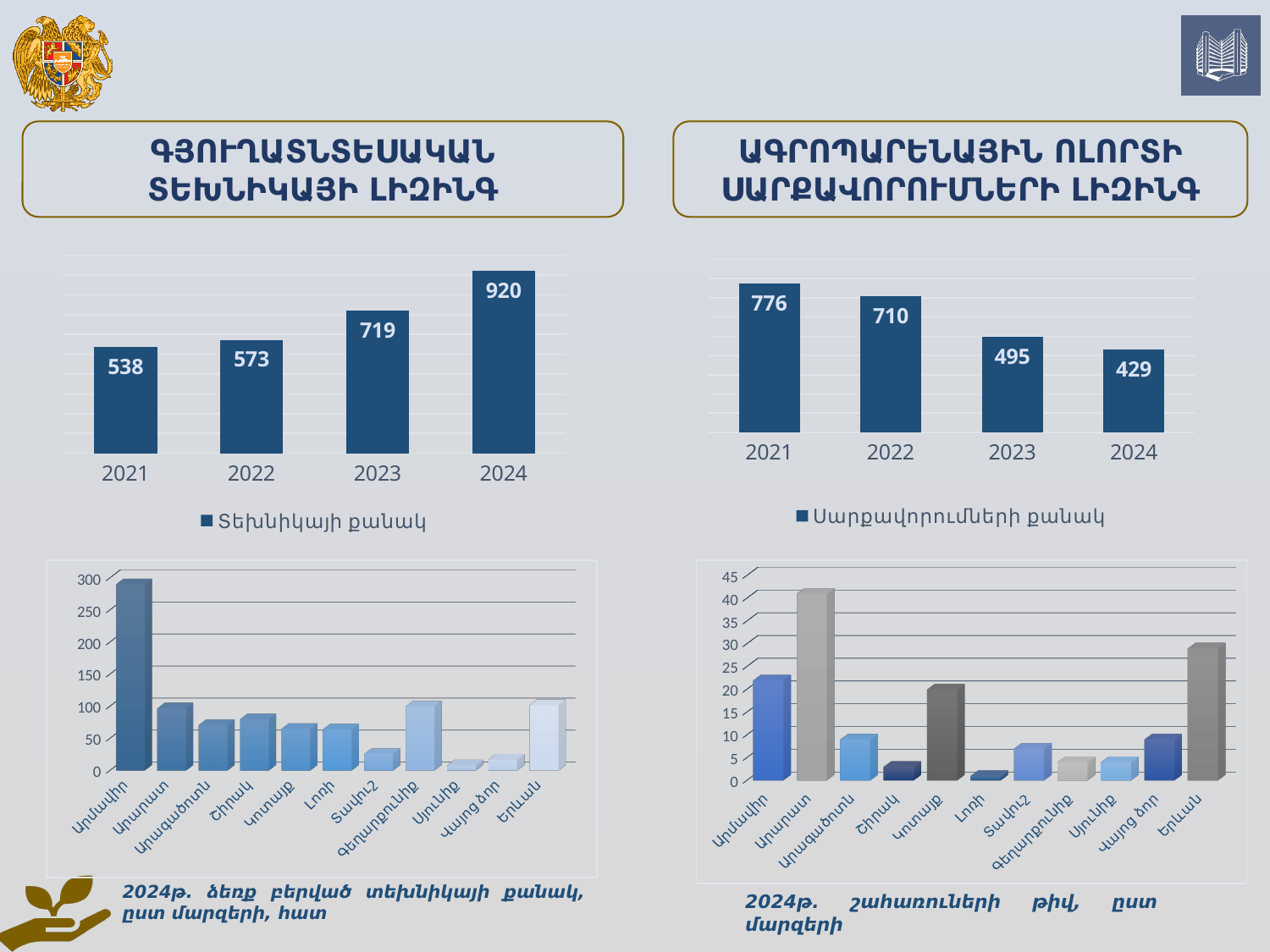
In the top-left chart, which year has the highest value? 2024 In the top-left chart, do the values rise or fall from 2021 to 2024? rise In the bottom-left chart, is the value for Արմավիր greater or less than 250? greater In the top-right chart, do the values rise or fall from 2021 to 2024? fall In the top-right chart, which year has the lowest value? 2024 In the top-left chart, what is the difference between the 2024 and 2023 values? 201 What kind of chart is the top-left chart? bar chart In the top-left chart, what is the value for 2021? 538 In the top-right chart, what is the difference between the 2021 and 2024 values? 347 How many categories are shown on the x axis of the bottom-right chart? 11 In the top-right chart, what is the value for 2022? 710 In the top-left chart, what is the value for 2024? 920